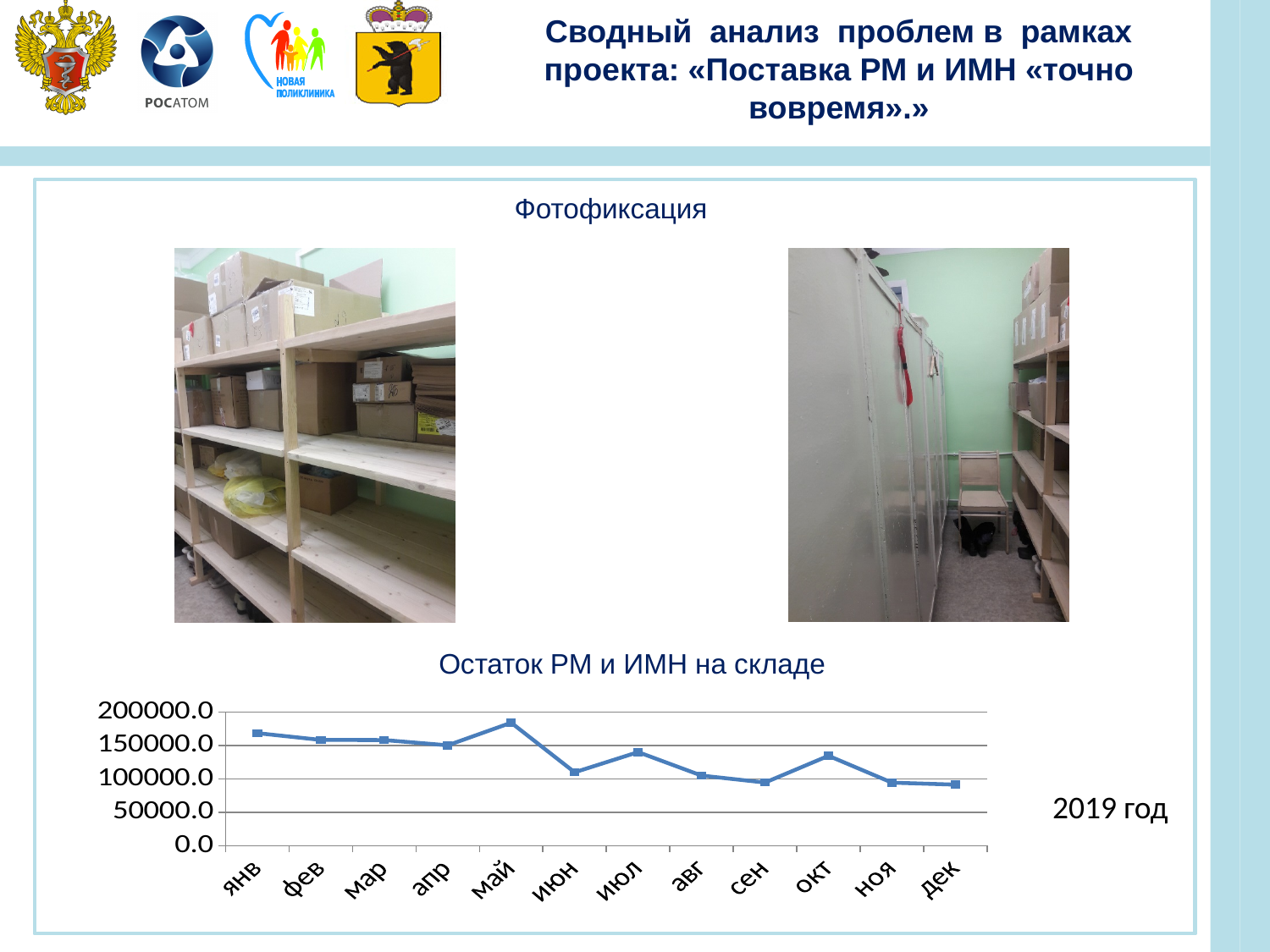
Is the value for дек greater or less than 100000.0? less How many months are plotted along the x axis of the chart? 12 What is the title of the chart? Остаток РМ и ИМН на складе Is the value for янв greater or less than 150000.0? greater In which month is the plotted value highest? май Overall, do the values rise or fall from янв to дек? fall What kind of chart is shown under the heading "Остаток РМ и ИМН на складе"? line chart Is the value for июл greater or less than 150000.0? less Which month has the larger value, май or июн? май Which month has the larger value, янв or дек? янв